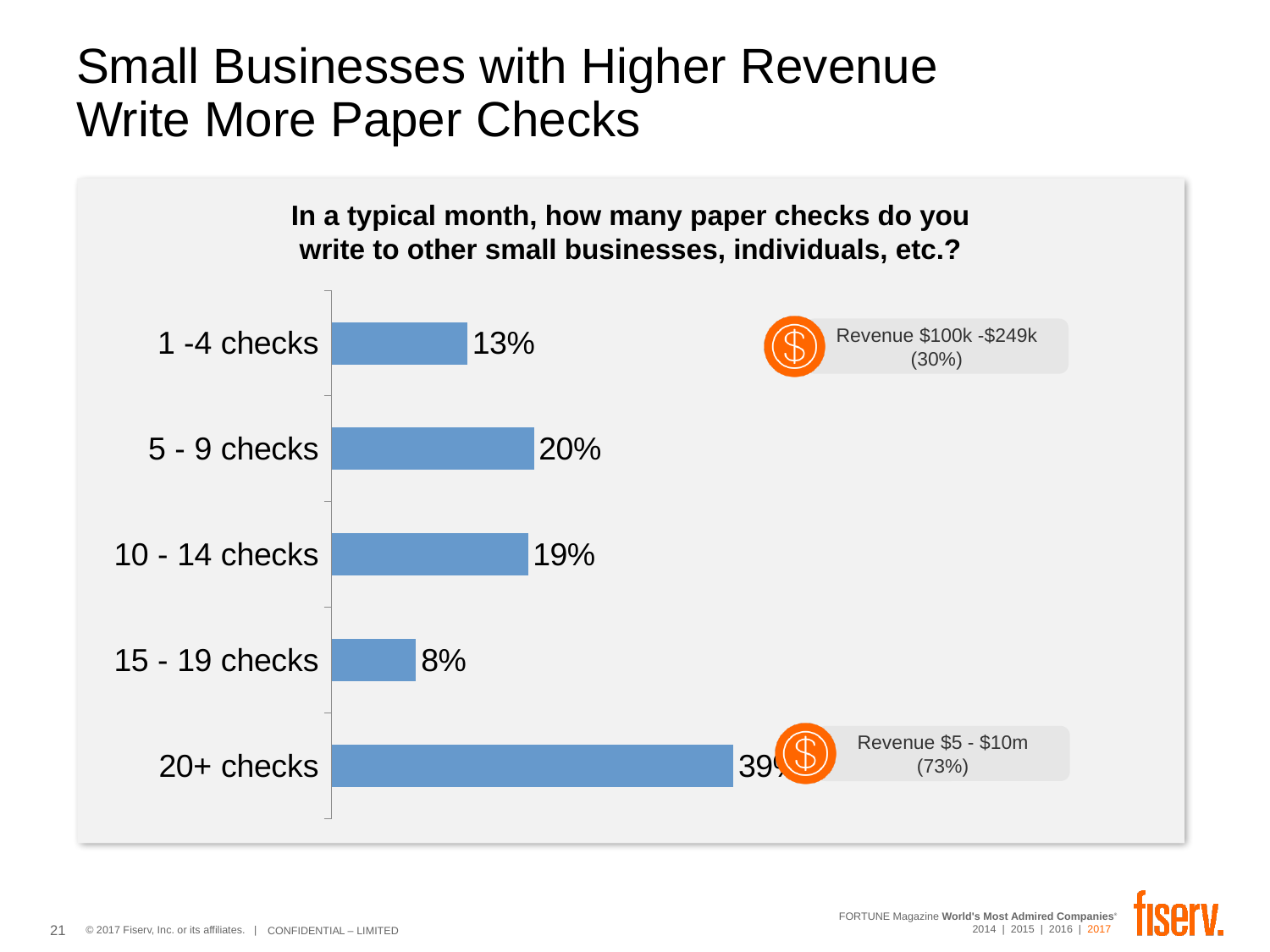
According to the callout next to the 20+ checks bar, what share of businesses with revenue of $5 - $10m write 20+ checks? 73% What is the difference between the values for 5 - 9 checks and 1 -4 checks? 7% Which category has the longest bar in the chart? 20+ checks What percentage is shown for 10 - 14 checks? 19% What percentage of respondents write 1-4 checks in a typical month? 13% What kind of chart is shown on the slide? Bar chart What is the value shown for the 5 - 9 checks category? 20% What is the difference between the values for 10 - 14 checks and 15 - 19 checks? 11% How many categories are shown in the chart? 5 Which is larger, the value for 1 -4 checks or the value for 15 - 19 checks? 1 -4 checks Which category has the smallest value in the chart? 15 - 19 checks What is the value for the 15 - 19 checks category? 8%